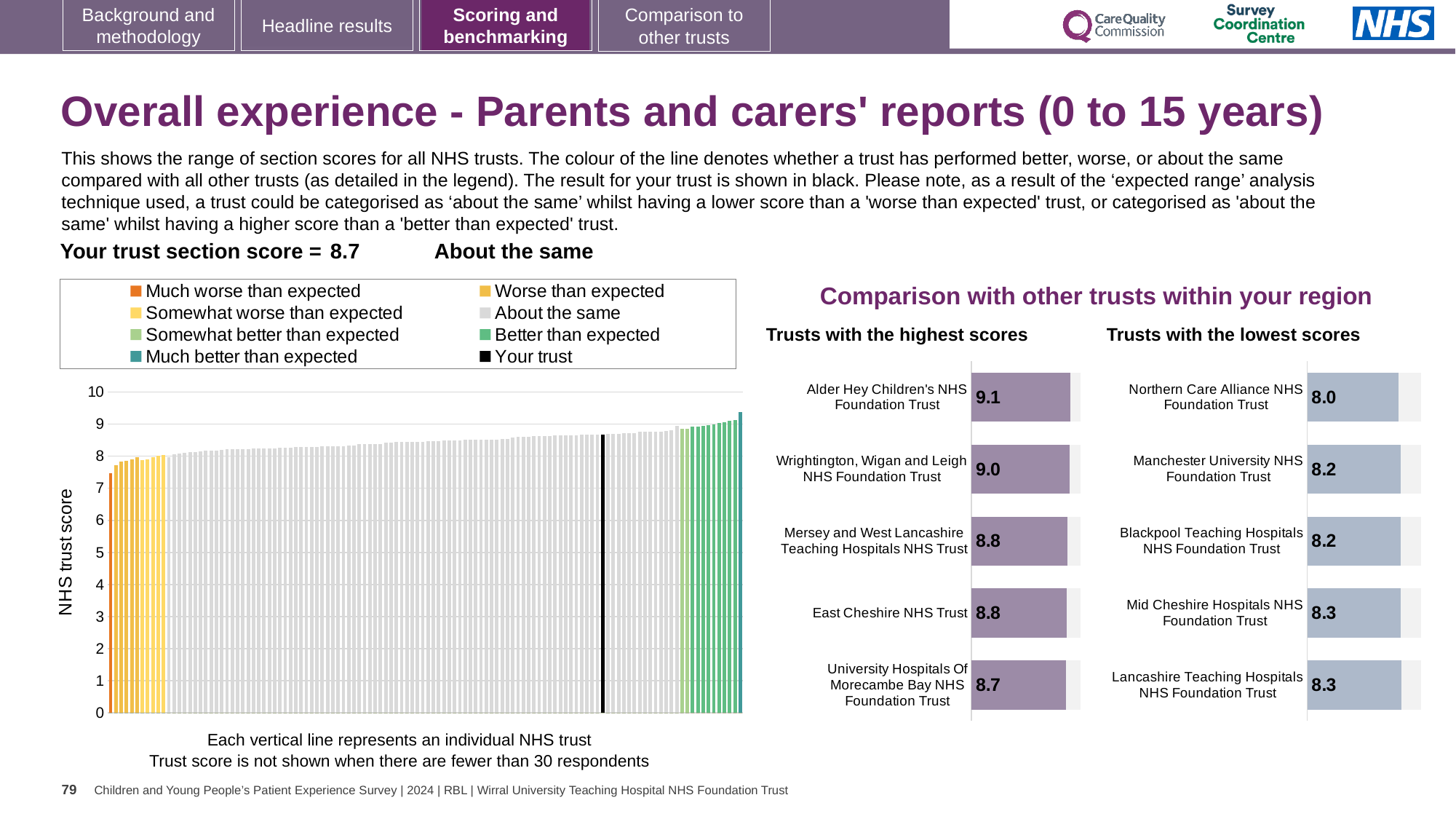
How many entries does the legend of the main 'NHS trust score' chart list? 8 In the 'Trusts with the highest scores' chart, what is the score for Alder Hey Children's NHS Foundation Trust? 9.1 In the 'Trusts with the lowest scores' chart, which trust has the lowest score? Northern Care Alliance NHS Foundation Trust In the 'Trusts with the lowest scores' chart, what is the score for Northern Care Alliance NHS Foundation Trust? 8.0 In the 'Trusts with the highest scores' chart, which trust has the highest score? Alder Hey Children's NHS Foundation Trust Which has the larger score: Wrightington, Wigan and Leigh NHS Foundation Trust in the highest scores chart, or Mid Cheshire Hospitals NHS Foundation Trust in the lowest scores chart? Wrightington, Wigan and Leigh NHS Foundation Trust What is the section score for your trust shown on the slide? 8.7 In the main 'NHS trust score' chart, do the bar values rise or fall from left to right? Rise What kind of chart is the main chart showing the range of section scores for all NHS trusts? Bar chart In the main chart, is the value of the leftmost (much worse than expected) bar greater or less than 8? less In the 'Trusts with the highest scores' chart, what is the difference between the scores of Alder Hey Children's NHS Foundation Trust and University Hospitals Of Morecambe Bay NHS Foundation Trust? 0.4 How many trusts are shown in the 'Trusts with the highest scores' chart? 5